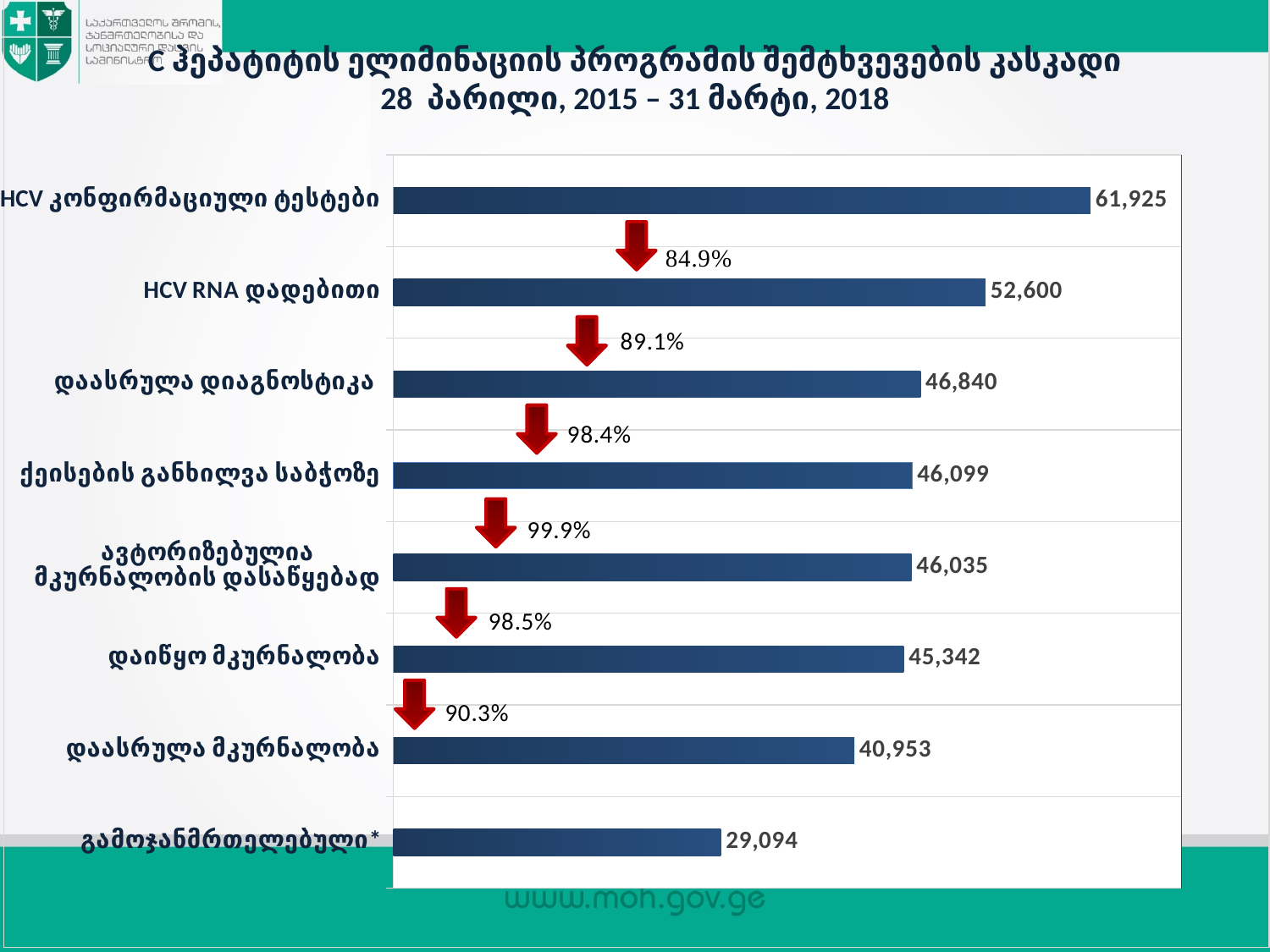
What value is shown for დაიწყო მკურნალობა? 45,342 What value is shown for HCV RNA დადებითი? 52,600 What kind of chart is shown on the slide? Bar chart What is the difference between the values for დაასრულა მკურნალობა and გამოჯანმრთელებული*? 11,859 What is the difference between the values for HCV კონფირმაციული ტესტები and HCV RNA დადებითი? 9,325 How many categories are shown in the chart? 8 Which is larger, the value for დაასრულა დიაგნოსტიკა or the value for დაასრულა მკურნალობა? დაასრულა დიაგნოსტიკა What percentage is shown by the red arrow between HCV RNA დადებითი and დაასრულა დიაგნოსტიკა? 89.1% What value is shown for HCV კონფირმაციული ტესტები? 61,925 Which category has the lowest value? გამოჯანმრთელებული* What value is shown for გამოჯანმრთელებული*? 29,094 Which category has the highest value? HCV კონფირმაციული ტესტები